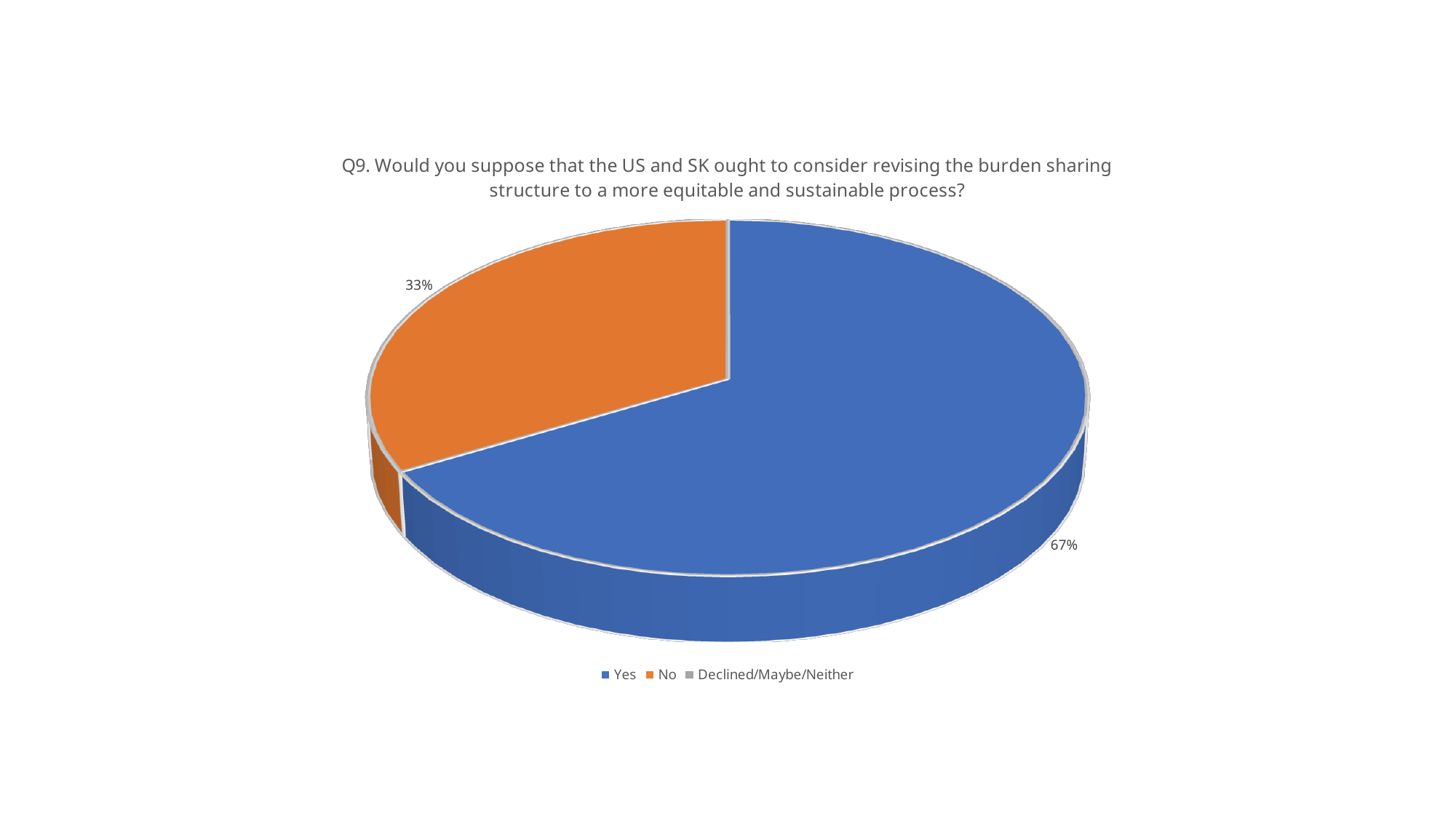
What percentage of respondents answered Yes? 67% What colour is the Yes slice? Blue Which response has the largest share of the pie? Yes What is the third legend entry after Yes and No? Declined/Maybe/Neither What percentage of respondents answered No? 33% What kind of chart is shown on the slide? Pie chart What is the difference in percentage points between the Yes and No slices? 34 Is the share for No greater or less than 50%? less How many slices are visible in the pie? 2 How many entries does the legend list? 3 Which of the two labelled slices is larger, Yes or No? Yes